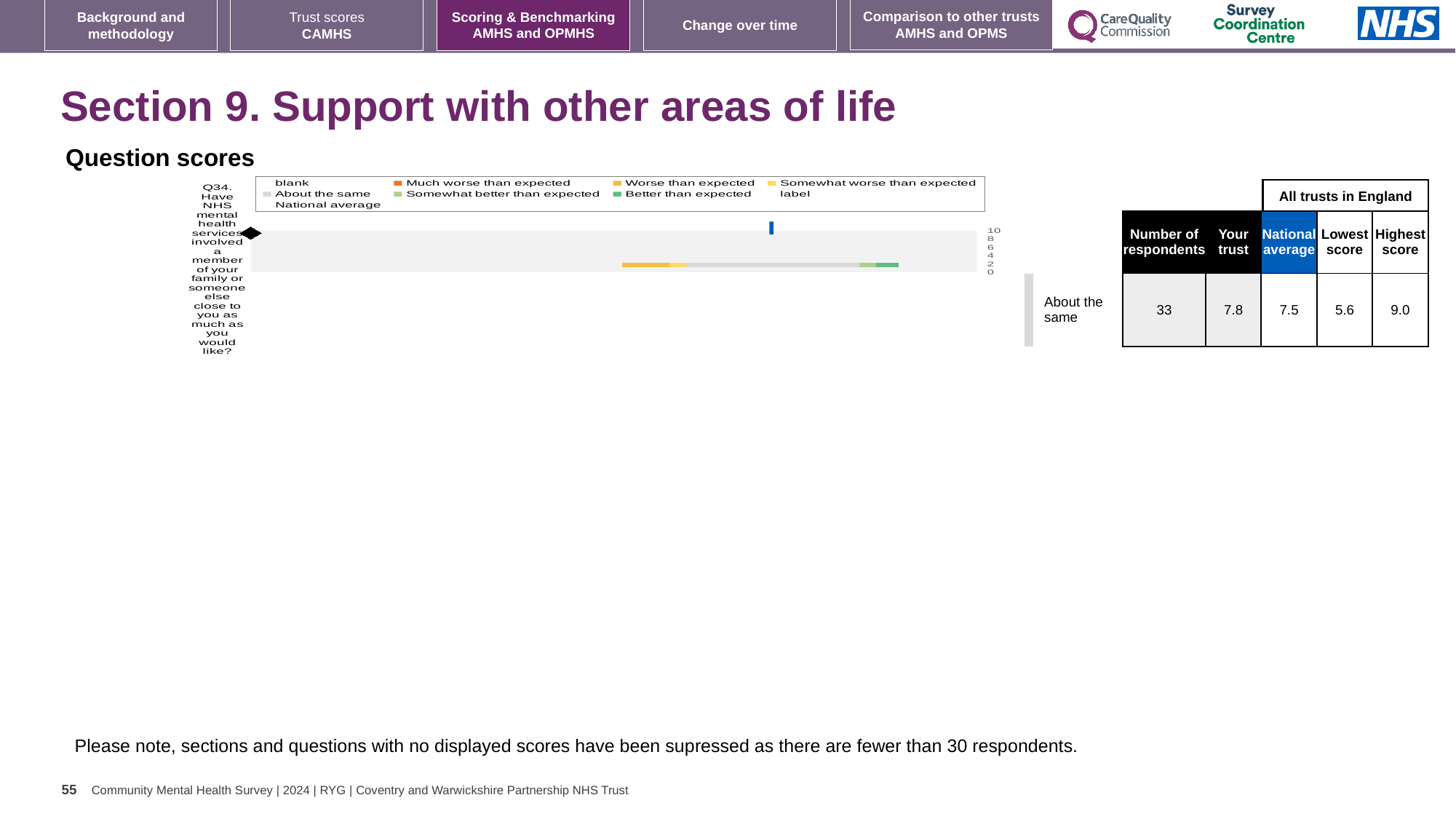
In the table beside the Question scores chart, what is the 'Your trust' score for Q34? 7.8 What is the highest value shown on the axis of the Question scores chart? 10 In the table beside the Question scores chart, what is the Lowest score among all trusts in England for Q34? 5.6 Is the 'Your trust' score for Q34 larger or smaller than the National average? larger In the table beside the Question scores chart, what is the Highest score among all trusts in England for Q34? 9.0 What is the difference between the Highest score and the Lowest score for Q34 in the table beside the chart? 3.4 How many questions (categories) are plotted in the Question scores chart? 1 In the table beside the Question scores chart, what is the National average for Q34? 7.5 What kind of chart is shown under 'Question scores'? bar chart What benchmark category is shown next to the Q34 bar in the Question scores chart? About the same Which question number is plotted in the Question scores chart? Q34 In the table beside the Question scores chart, how many respondents answered Q34? 33